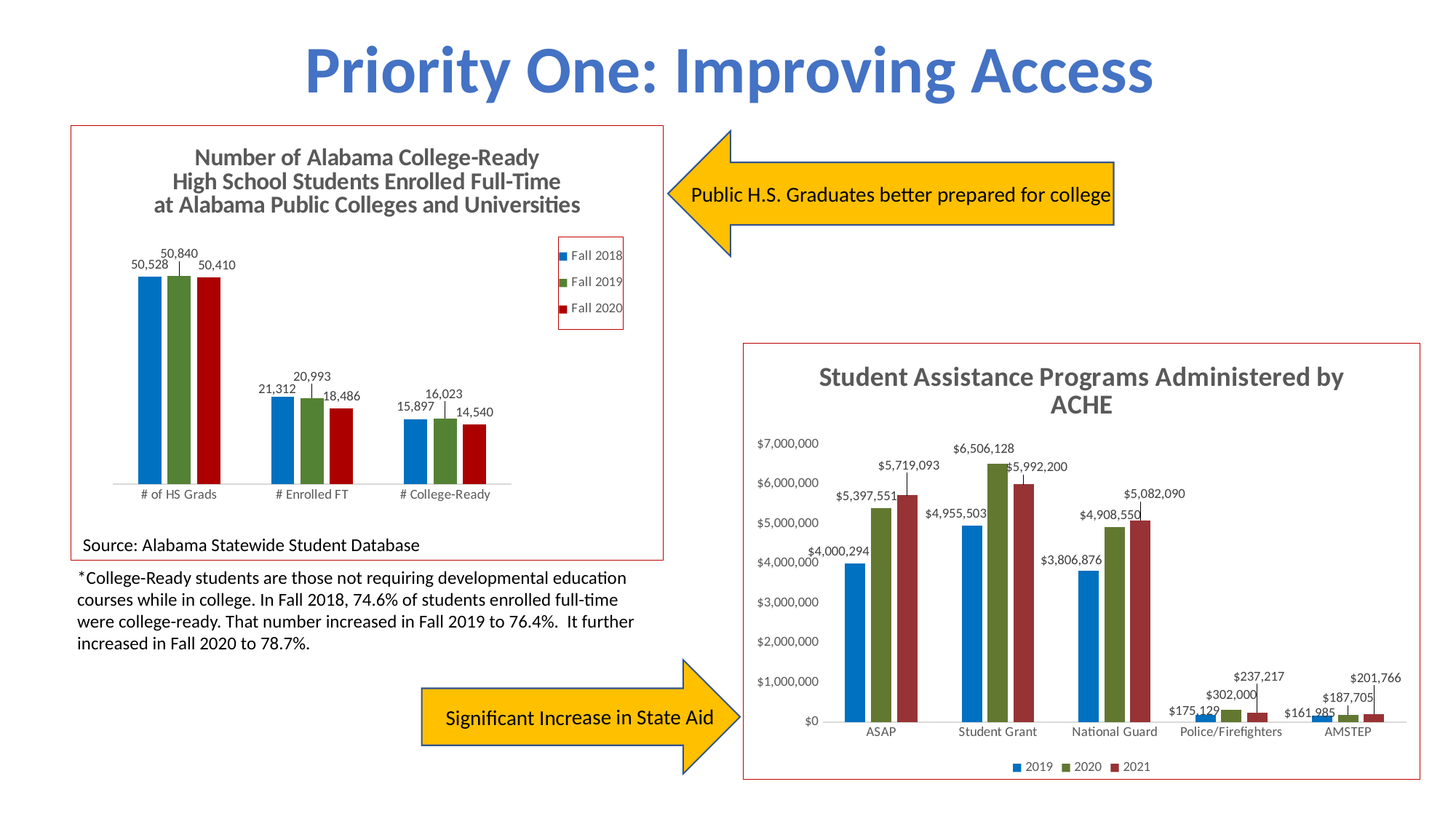
In the 'Student Assistance Programs Administered by ACHE' chart, which category has the lowest 2021 value? AMSTEP In the 'Student Assistance Programs Administered by ACHE' chart, what is the difference between the 2021 and 2019 values for ASAP? $1,718,799 In the 'Number of Alabama College-Ready High School Students' chart, what is the Fall 2019 value for # Enrolled FT? 20,993 In the 'Number of Alabama College-Ready High School Students' chart, which series has the highest value for # of HS Grads? Fall 2019 In the 'Student Assistance Programs Administered by ACHE' chart, what is the 2019 value for AMSTEP? $161,985 In the 'Student Assistance Programs Administered by ACHE' chart, what is the 2020 value for Student Grant? $6,506,128 In the 'Student Assistance Programs Administered by ACHE' chart, is the 2021 value for ASAP larger or smaller than the 2021 value for National Guard? larger In the 'Number of Alabama College-Ready High School Students' chart, what is the Fall 2020 value for # College-Ready? 14,540 In the 'Number of Alabama College-Ready High School Students' chart, what is the difference between the Fall 2018 and Fall 2020 values for # Enrolled FT? 2,826 In the 'Student Assistance Programs Administered by ACHE' chart, how many program categories are shown on the x axis? 5 In the 'Number of Alabama College-Ready High School Students' chart, how many series does the legend list? 3 What kind of chart is 'Student Assistance Programs Administered by ACHE'? bar chart